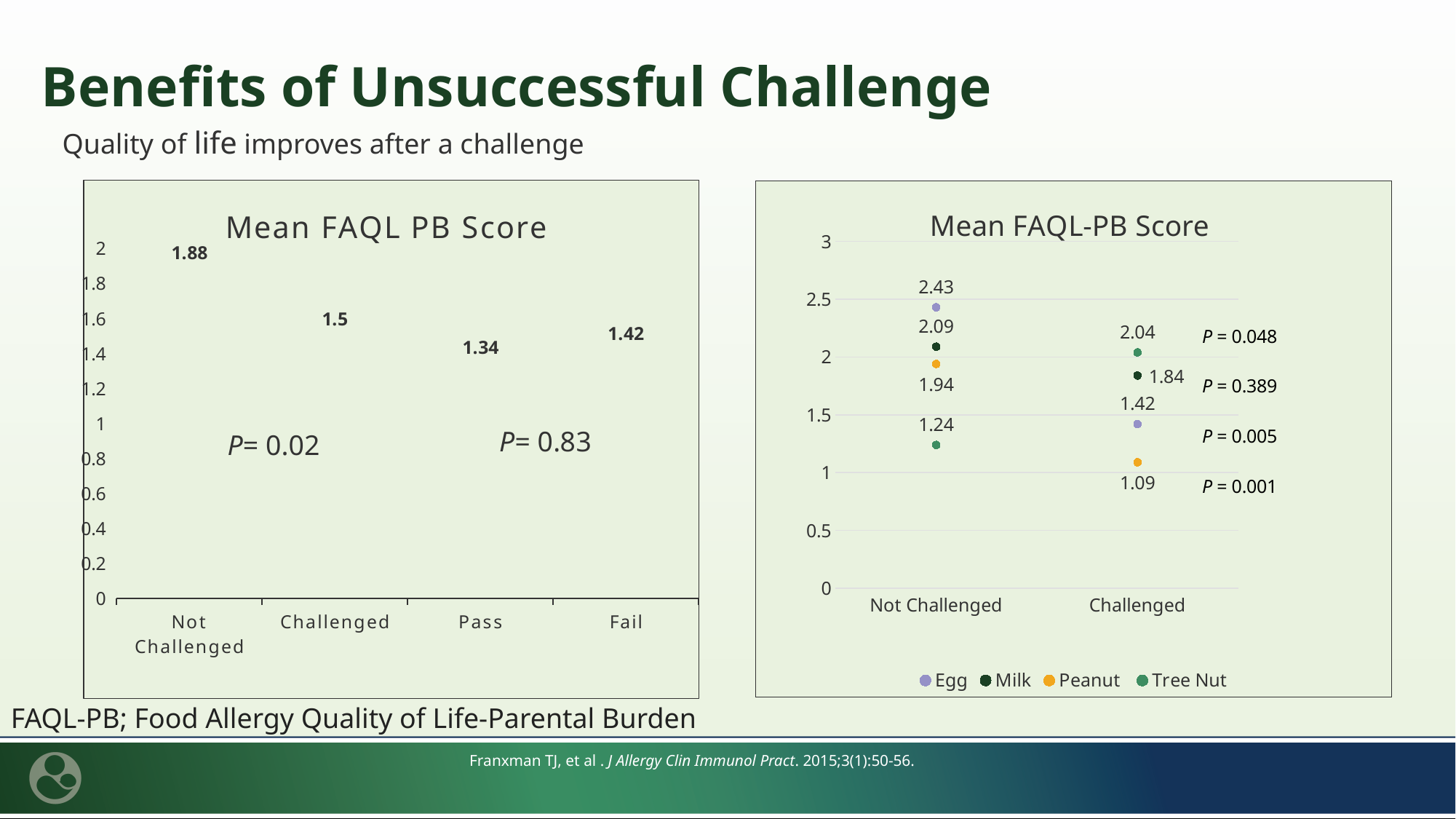
In the left chart titled "Mean FAQL PB Score", which category has the highest value? Not Challenged In the right chart titled "Mean FAQL-PB Score", what is the difference between the Egg values for Not Challenged and Challenged? 1.01 In the left chart titled "Mean FAQL PB Score", what is the value for Not Challenged? 1.88 In the right chart titled "Mean FAQL-PB Score", what is the Peanut value for Challenged? 1.09 In the left chart titled "Mean FAQL PB Score", how many categories are shown on the x axis? 4 In the left chart titled "Mean FAQL PB Score", what is the difference between the Not Challenged and Challenged values? 0.38 In the right chart titled "Mean FAQL-PB Score", how many series does the legend list? 4 In the right chart titled "Mean FAQL-PB Score", which series has the lowest value for Not Challenged? Tree Nut In the left chart titled "Mean FAQL PB Score", which category has the lowest value? Pass In the right chart titled "Mean FAQL-PB Score", is the Tree Nut value larger for Not Challenged or for Challenged? Challenged In the right chart titled "Mean FAQL-PB Score", what is the Egg value for Not Challenged? 2.43 In the left chart titled "Mean FAQL PB Score", what is the value for Pass? 1.34